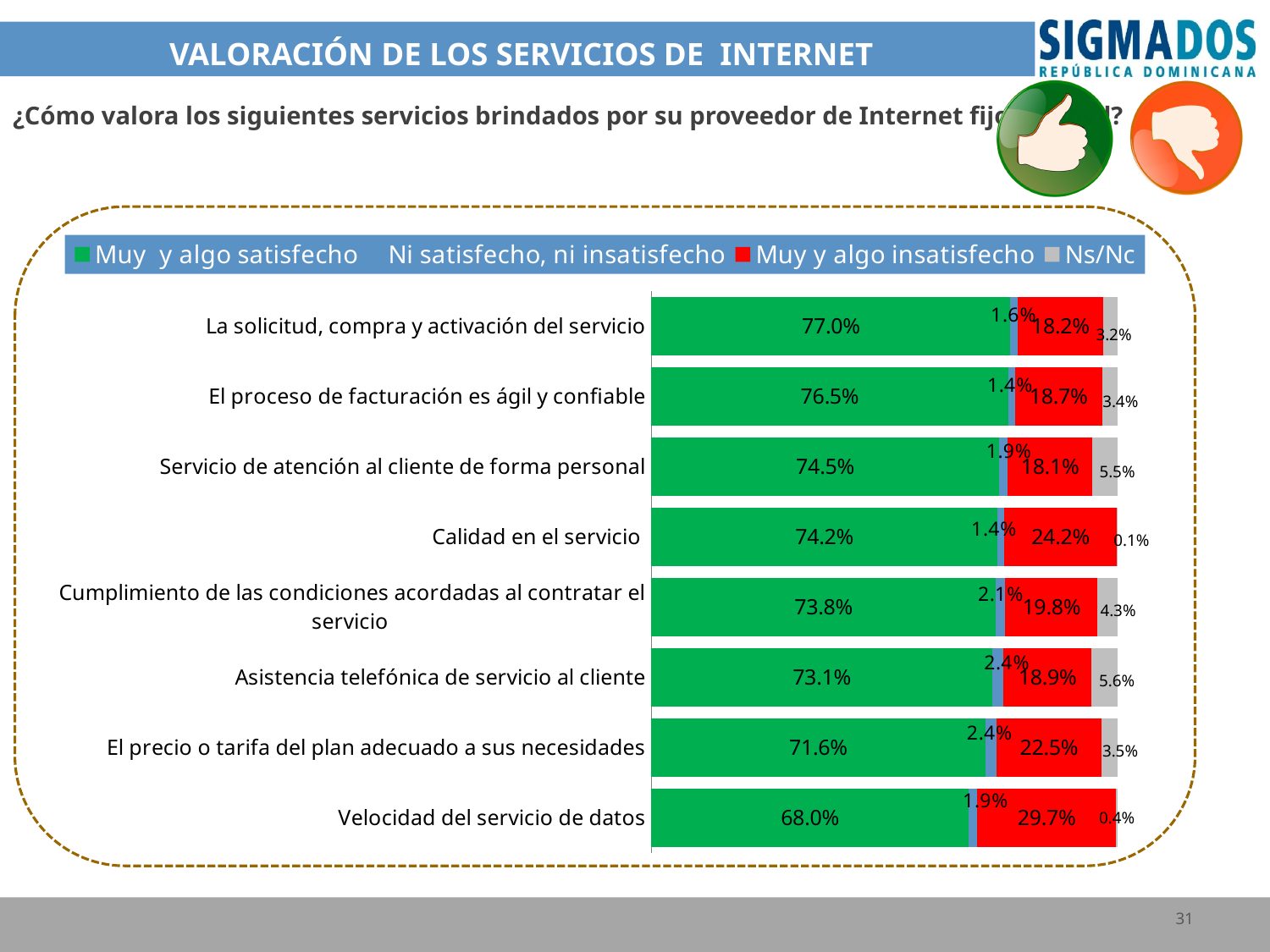
How many services are listed in the chart? 8 Which has a larger 'Muy y algo insatisfecho' value: 'El precio o tarifa del plan adecuado a sus necesidades' or 'El proceso de facturación es ágil y confiable'? El precio o tarifa del plan adecuado a sus necesidades What is the 'Ns/Nc' value for 'Asistencia telefónica de servicio al cliente'? 5.6% Which service has the lowest 'Muy y algo satisfecho' percentage? Velocidad del servicio de datos How many series does the legend list? 4 Which service has the highest 'Muy y algo satisfecho' percentage? La solicitud, compra y activación del servicio What percentage of respondents are 'Muy y algo satisfecho' with 'Velocidad del servicio de datos'? 68.0% Which colour represents 'Muy y algo insatisfecho' in the chart? Red What type of chart is shown on the slide? Stacked bar chart What is the 'Muy y algo insatisfecho' value for 'Calidad en el servicio'? 24.2% Which service has the highest 'Muy y algo insatisfecho' percentage? Velocidad del servicio de datos What is the difference between the 'Muy y algo satisfecho' values for 'La solicitud, compra y activación del servicio' and 'Velocidad del servicio de datos'? 9.0%